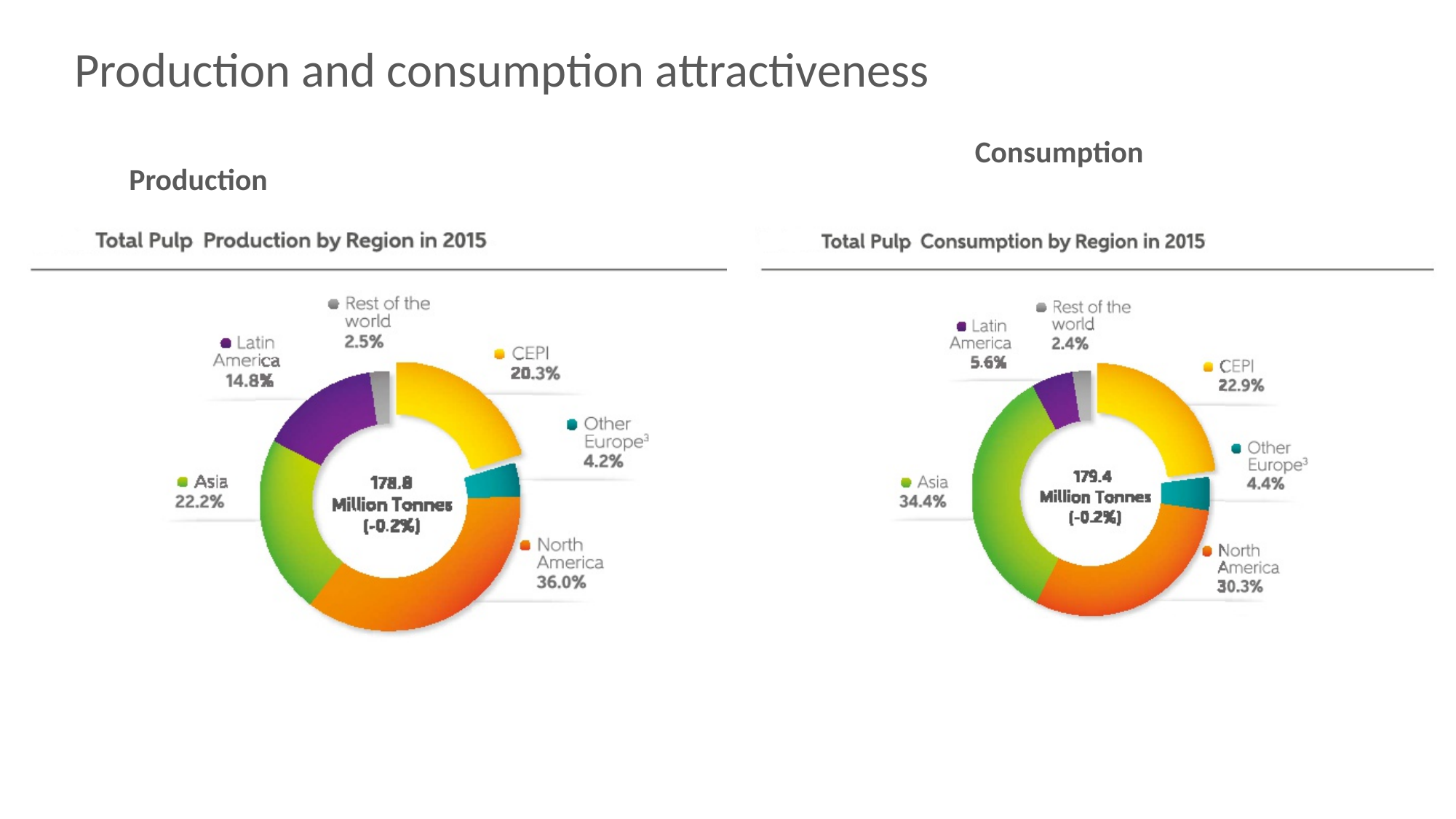
In the Total Pulp Production by Region in 2015 chart, what share does North America have? 36.0% In the Total Pulp Consumption by Region in 2015 chart, which region has the smallest share? Rest of the world How many regions are shown in the Total Pulp Production by Region in 2015 chart? 6 In the Total Pulp Production by Region in 2015 chart, which region has the largest share? North America In the Total Pulp Consumption by Region in 2015 chart, what share does Other Europe have? 4.4% In the Total Pulp Production by Region in 2015 chart, what colour represents Asia? Green In the Total Pulp Production by Region in 2015 chart, what is the difference between the shares of North America and Asia? 13.8% What total value is shown in the centre of the Total Pulp Consumption by Region in 2015 chart? 179.4 Million Tonnes In the Total Pulp Consumption by Region in 2015 chart, which is larger, the share of CEPI or the share of Latin America? CEPI What kind of chart is the Total Pulp Consumption by Region in 2015 chart? Pie chart (donut) In the Total Pulp Consumption by Region in 2015 chart, what share does Asia have? 34.4% What total value is shown in the centre of the Total Pulp Production by Region in 2015 chart? 178.8 Million Tonnes